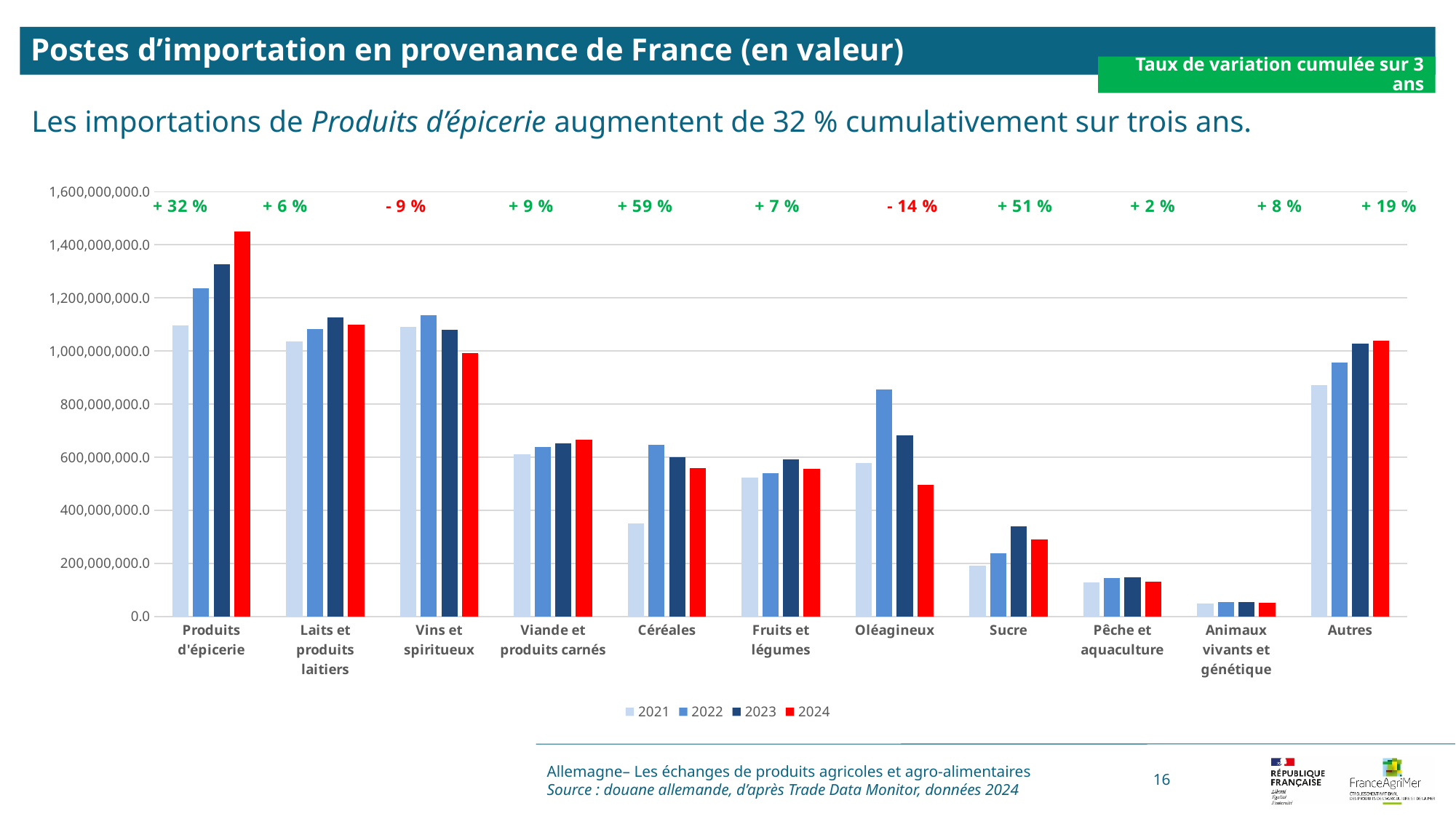
Is the 2024 value for Produits d'épicerie greater or less than 1,400,000,000.0? greater What is the cumulative variation rate over 3 years printed above Oléagineux? - 14 % What is the title of the chart slide? Postes d'importation en provenance de France (en valeur) How many series does the legend list? 4 Do the bars for Produits d'épicerie rise or fall from 2021 to 2024? rise Which category has the highest cumulative variation rate printed above it? Céréales Is the 2024 value for Sucre greater or less than 400,000,000.0? less Which category has the lowest cumulative variation rate printed above it? Oléagineux Which is larger in 2024: Produits d'épicerie or Laits et produits laitiers? Produits d'épicerie What is the cumulative variation rate over 3 years printed above Céréales? + 59 % How many product categories are shown on the x axis? 11 What kind of chart is shown on the slide? bar chart